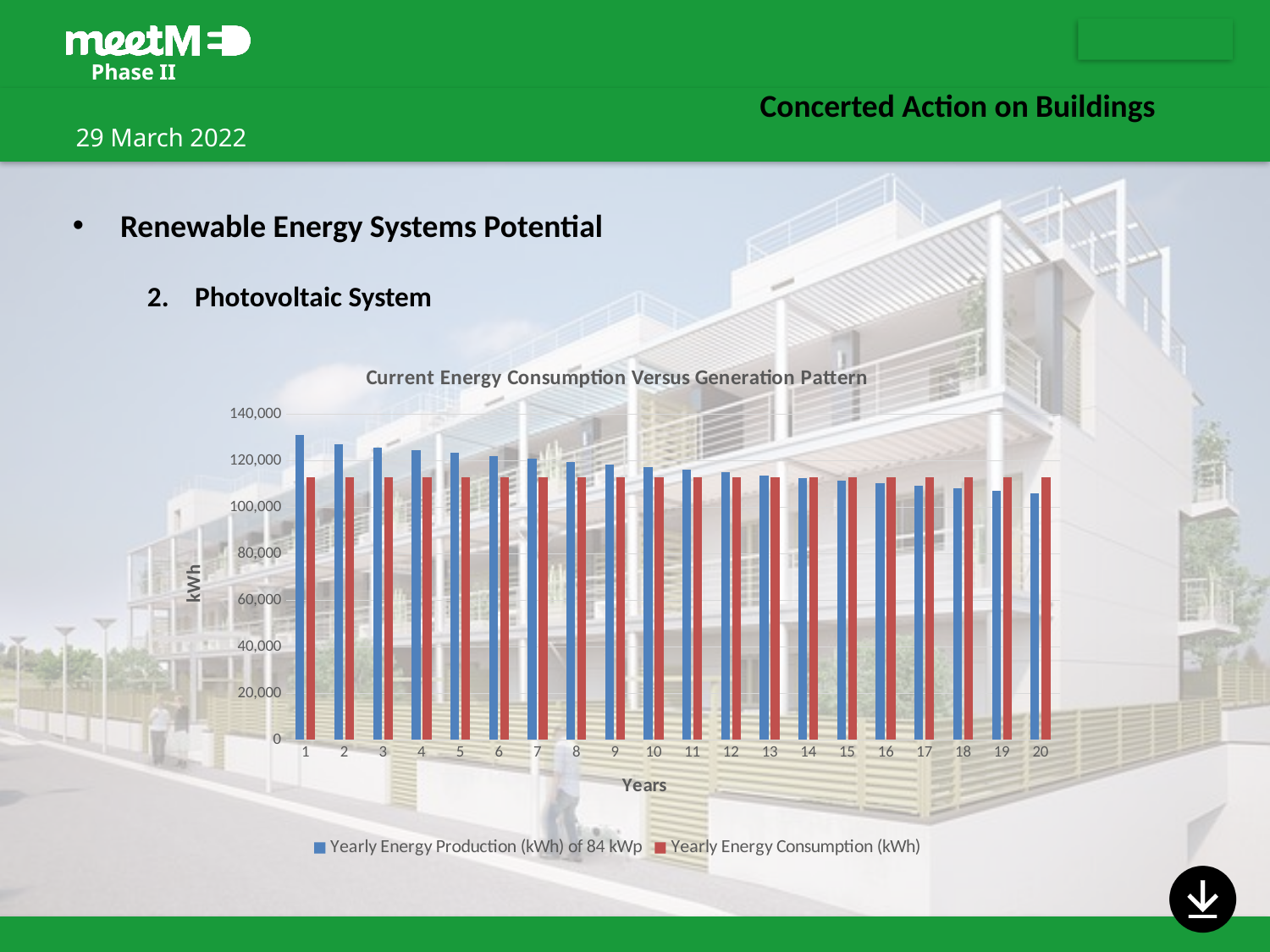
How many years are shown along the x axis of the chart? 20 How many series does the chart legend list? 2 In year 1, which is larger: Yearly Energy Production (kWh) of 84 kWp or Yearly Energy Consumption (kWh)? Yearly Energy Production (kWh) of 84 kWp Is the Yearly Energy Production (kWh) of 84 kWp in year 20 greater or less than 120,000? less Is the Yearly Energy Production (kWh) of 84 kWp in year 1 greater or less than 120,000? greater What kind of chart is shown on the slide? Bar chart In which year is the Yearly Energy Production (kWh) of 84 kWp highest? 1 In year 20, which is larger: Yearly Energy Production (kWh) of 84 kWp or Yearly Energy Consumption (kWh)? Yearly Energy Consumption (kWh) What is the title of the chart? Current Energy Consumption Versus Generation Pattern Is the Yearly Energy Consumption (kWh) in year 10 greater or less than 100,000? greater Does the Yearly Energy Production (kWh) of 84 kWp rise or fall from year 1 to year 20? Fall In which year is the Yearly Energy Production (kWh) of 84 kWp lowest? 20